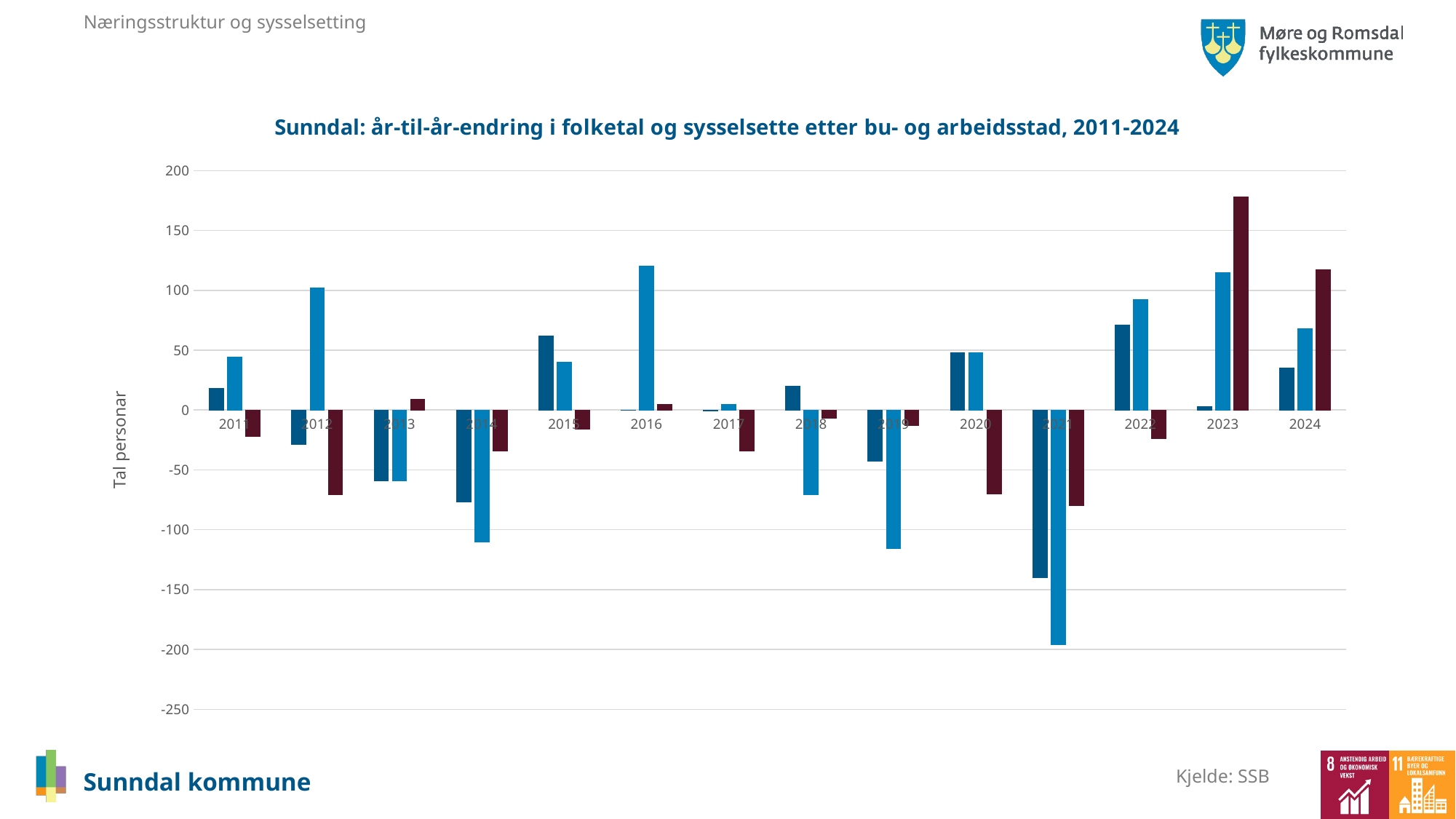
How many years are shown on the x axis of the chart? 14 Is the value of the dark blue bar for 2021 greater or less than -100? less What is the title of the chart? Sunndal: år-til-år-endring i folketal og sysselsette etter bu- og arbeidsstad, 2011-2024 In which year does the light blue bar reach its lowest value? 2021 Which is larger, the dark red bar for 2023 or the dark red bar for 2024? 2023 In which year does the dark red bar reach its highest value? 2023 What kind of chart is shown on the slide? bar chart What is the label on the vertical axis of the chart? Tal personar Is the value of the light blue bar for 2016 greater or less than 100? greater Is the value of the light blue bar for 2022 greater or less than 100? less